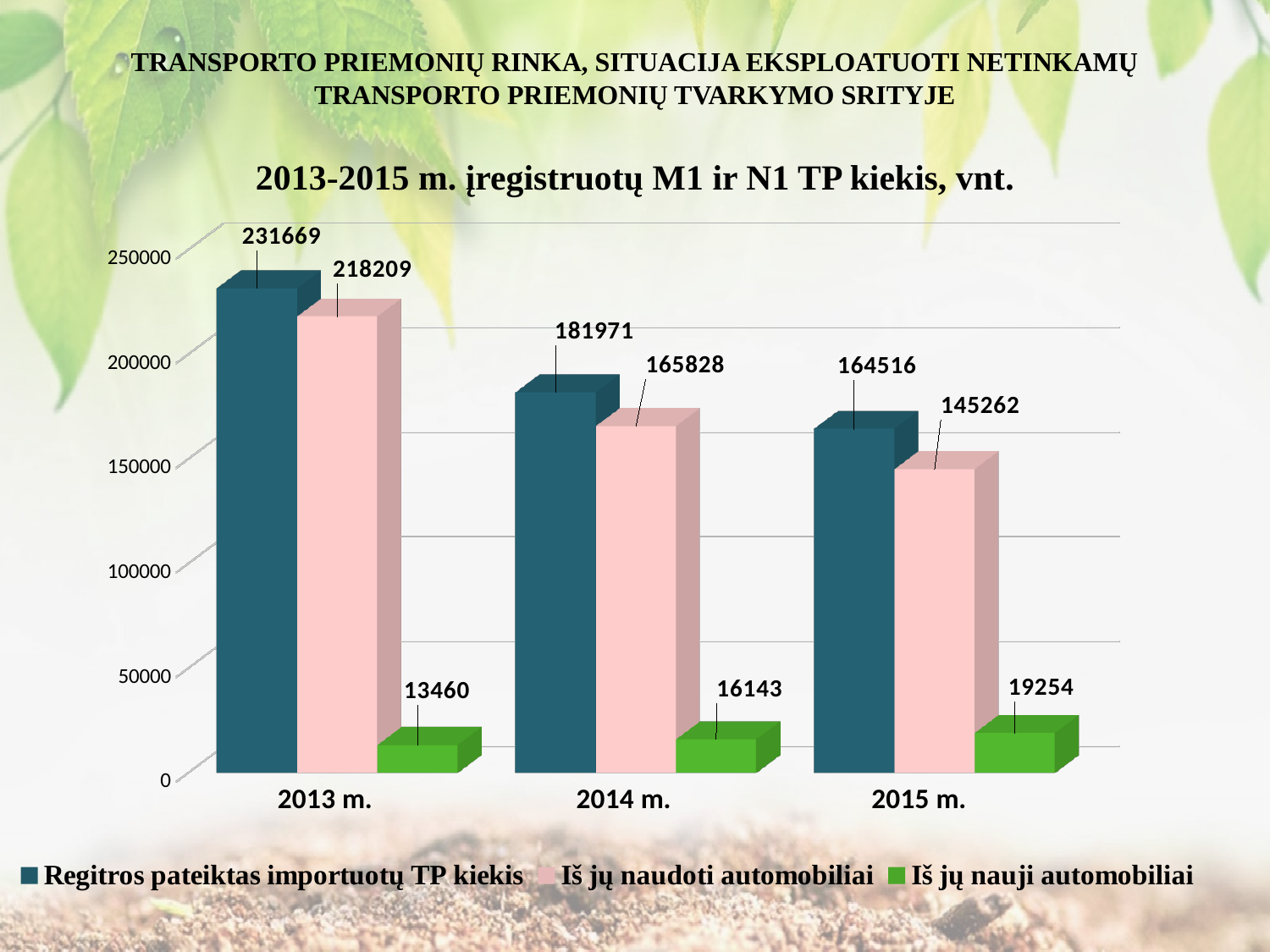
What is the value of 'Iš jų nauji automobiliai' for 2014 m.? 16143 Which is larger: 'Iš jų nauji automobiliai' in 2015 m. or in 2013 m.? 2015 m. Does 'Regitros pateiktas importuotų TP kiekis' rise or fall from 2013 m. to 2015 m.? fall What is the value of 'Iš jų naudoti automobiliai' for 2015 m.? 145262 In which year is 'Regitros pateiktas importuotų TP kiekis' the highest? 2013 m. In which year is 'Iš jų nauji automobiliai' the lowest? 2013 m. How many series does the legend list? 3 What is the difference between 'Regitros pateiktas importuotų TP kiekis' and 'Iš jų naudoti automobiliai' in 2014 m.? 16143 What is the value of 'Regitros pateiktas importuotų TP kiekis' for 2013 m.? 231669 How many years are shown on the x axis? 3 Is the value of 'Iš jų naudoti automobiliai' for 2013 m. greater or less than 200000? greater What kind of chart is shown on the slide? bar chart